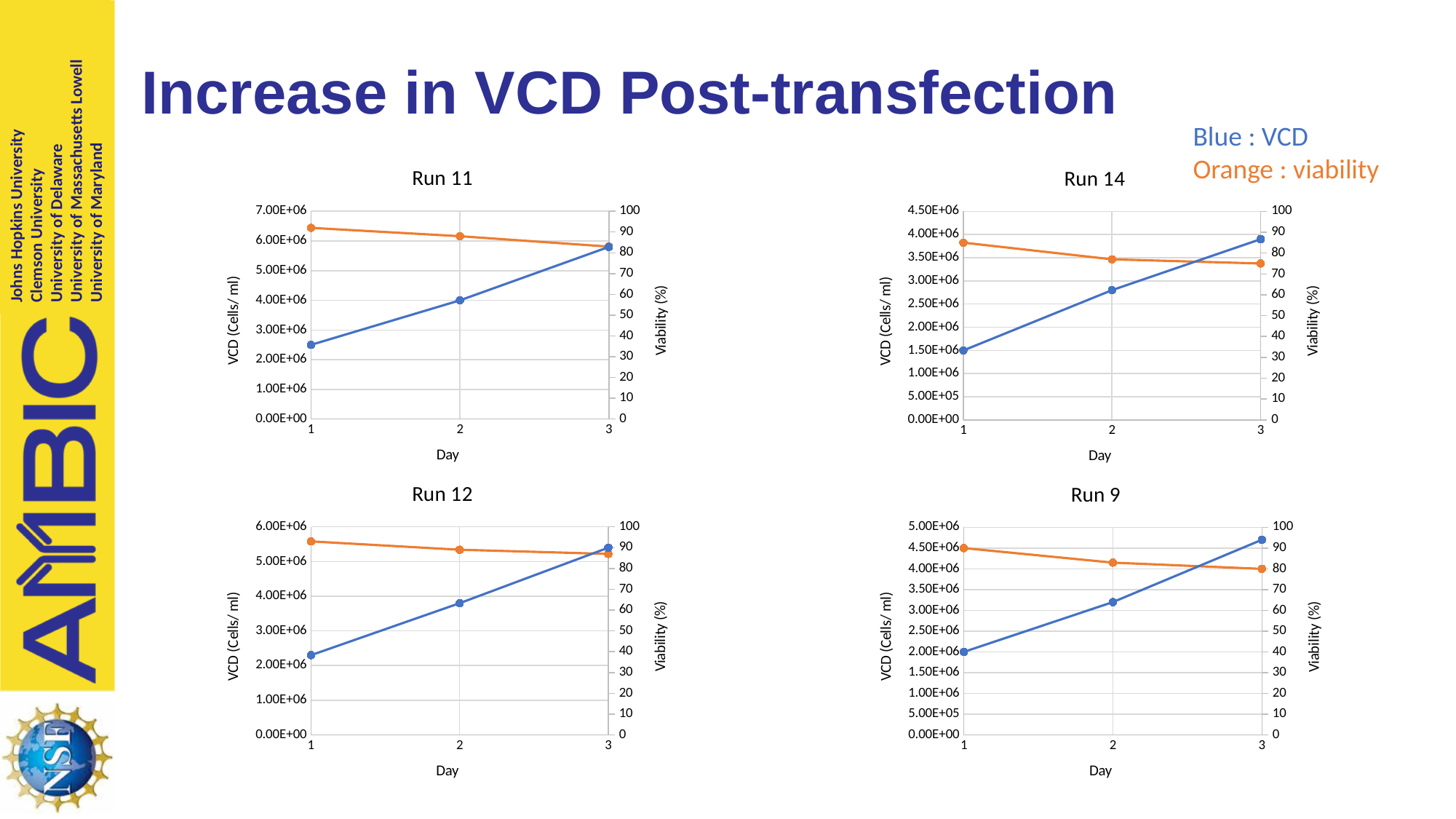
In the Run 9 chart, what is the VCD value on day 1? 2.00E+06 How many days are plotted on the x axis of the Run 9 chart? 3 In the Run 12 chart, is the VCD value on day 3 greater or less than 5.00E+06? greater In the Run 14 chart, does the orange viability line rise or fall from day 1 to day 3? fall In the Run 11 chart, what is the VCD value on day 2? 4.00E+06 What kind of chart is the Run 11 chart? line chart In the Run 14 chart, what is the VCD value on day 1? 1.50E+06 In the Run 9 chart, what is the viability on day 3? 80 In the Run 11 chart, does the blue VCD line rise or fall from day 1 to day 3? rise According to the legend text on the slide, which colour represents viability? Orange In the Run 14 chart, is the viability on day 1 greater or less than 80? greater In the Run 11 chart, which day has the highest VCD? 3